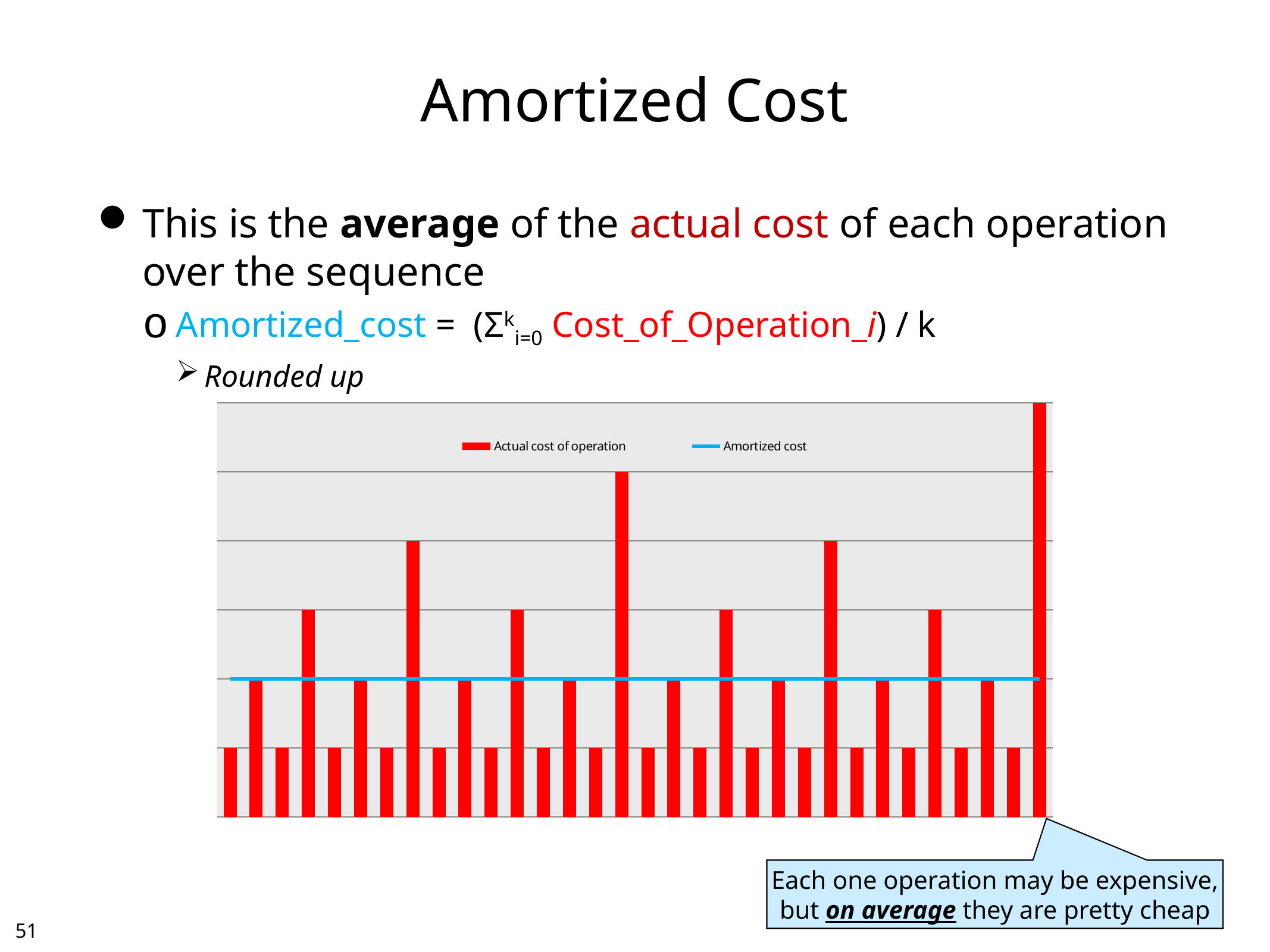
What kind of chart is shown on the slide? Bar chart with a line Which bar in the chart is the tallest? The rightmost (last) bar Is the rightmost bar taller or shorter than the tall bar near the middle of the chart? Taller How many series does the chart legend list? 2 Is the 'Amortized cost' line above or below the tallest bar? Below Is the 'Amortized cost' line above or below the height of the shortest bars? Above What colour are the bars for the 'Actual cost of operation' series? Red Does the 'Amortized cost' line rise, fall, or stay flat across the chart? Stays flat What are the two series named in the chart legend? Actual cost of operation; Amortized cost How many bars are plotted in the chart? 32